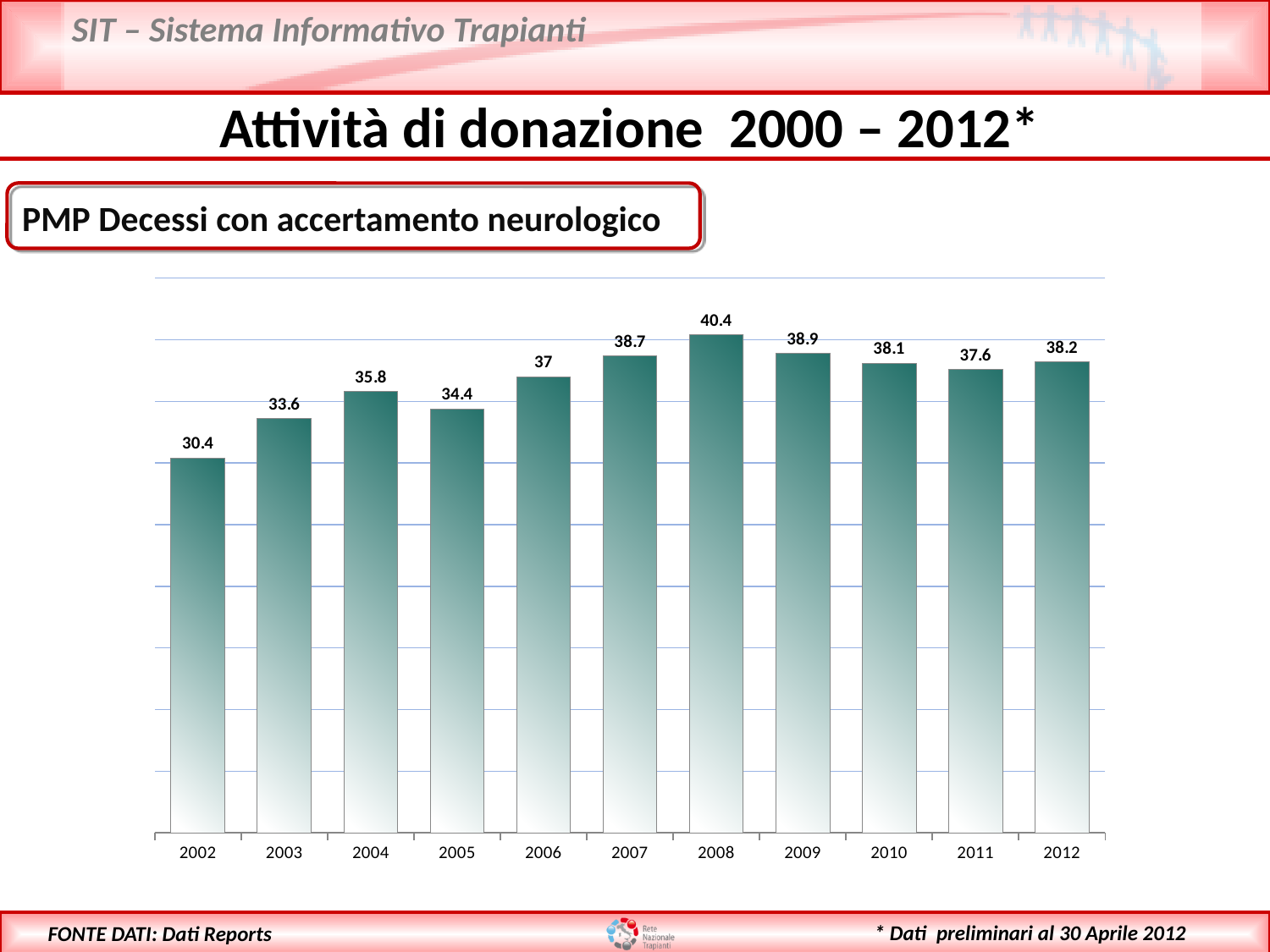
Which year has a larger PMP value, 2003 or 2006? 2006 What is the PMP value for 2008? 40.4 Which year has the highest PMP value? 2008 Which year has the lowest PMP value? 2002 Which year has a larger PMP value, 2007 or 2009? 2009 What is the PMP value for 2011? 37.6 What is the difference between the PMP values for 2004 and 2005? 1.4 What is the PMP value for 2002? 30.4 What is the difference between the PMP values for 2008 and 2002? 10 What kind of chart is shown on the slide? bar chart How many years are shown on the x axis of the chart? 11 What is the title shown in the box above the chart? PMP Decessi con accertamento neurologico